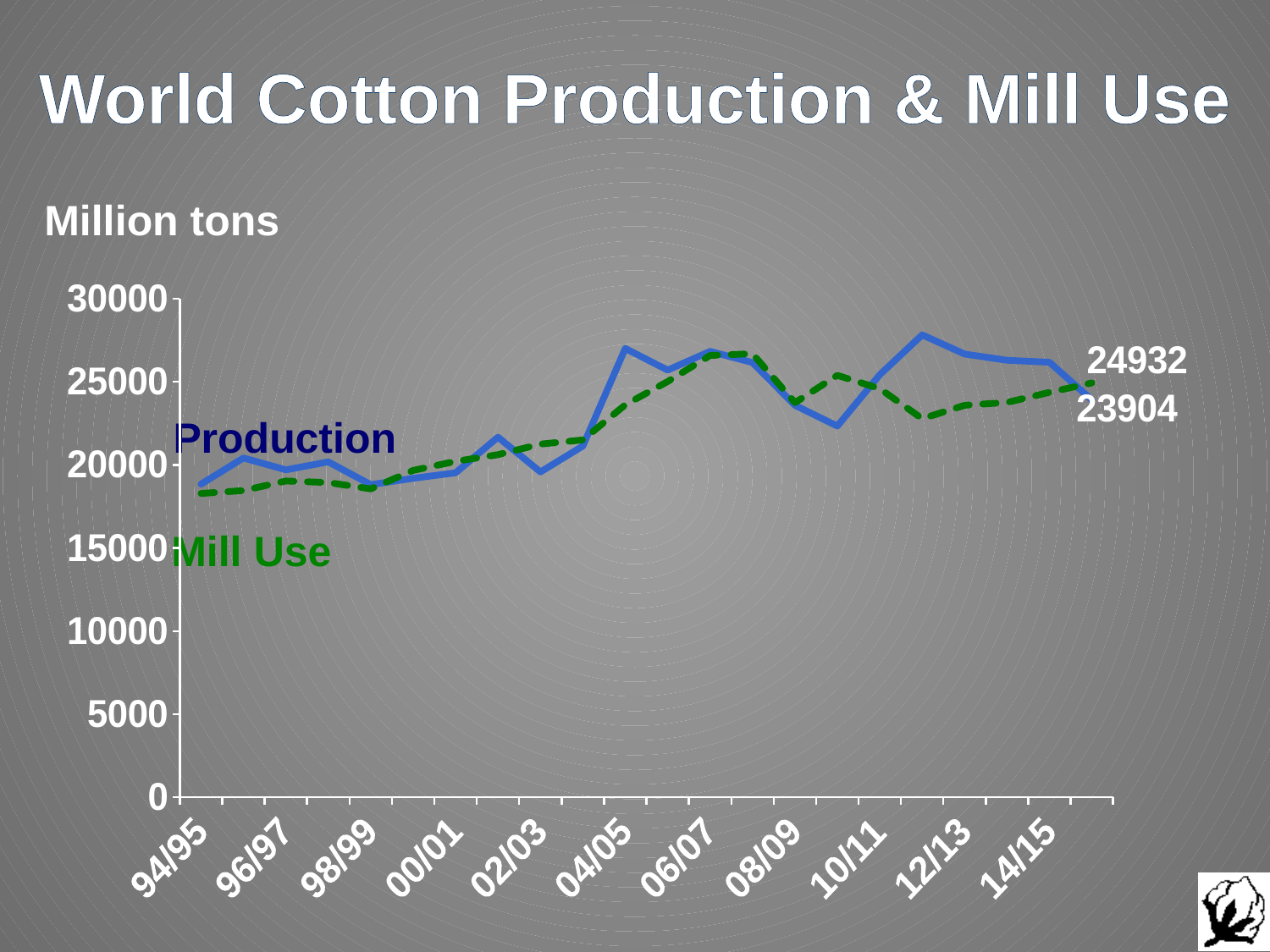
Is the Production value at 12/13 greater or less than 25000? greater How many data series are plotted on the chart? 2 What unit label is shown above the chart's vertical axis? Million tons What is the difference between the two values labeled at the right end of the chart, 24932 and 23904? 1028 How many season labels are shown on the x axis? 11 At 10/11, which series has the higher value, Production or Mill Use? Production Does the Production line overall rise or fall from 94/95 to 04/05? rise Is the Mill Use value at 94/95 greater or less than 20000? less What is the title of the chart? World Cotton Production & Mill Use Is the Production value at 04/05 greater or less than 25000? greater At 04/05, which series has the higher value, Production or Mill Use? Production What kind of chart is shown on the slide? line chart